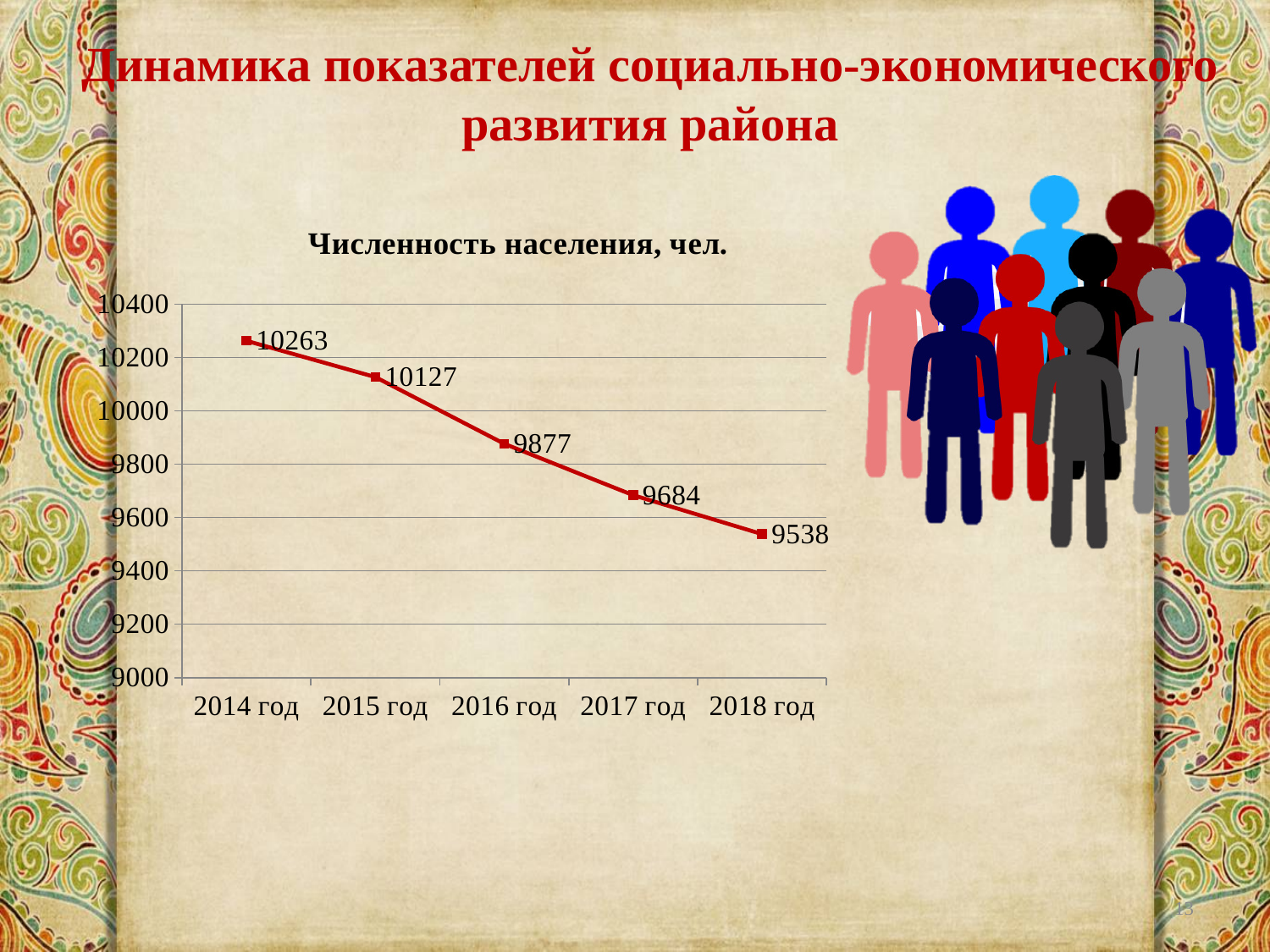
What is the difference between the population in 2014 год and 2018 год? 725 How many years are plotted on the chart? 5 What is the population value for 2018 год? 9538 What is the population value for 2014 год? 10263 Which year has the lowest population value? 2018 год Which is larger, the population in 2015 год or in 2017 год? 2015 год Which year has the highest population value? 2014 год What is the population value for 2016 год? 9877 What is the difference between the population in 2015 год and 2016 год? 250 Is the population value for 2017 год greater or less than 9800? less Do the population values rise or fall from 2014 год to 2018 год? fall What kind of chart is shown on the slide? line chart